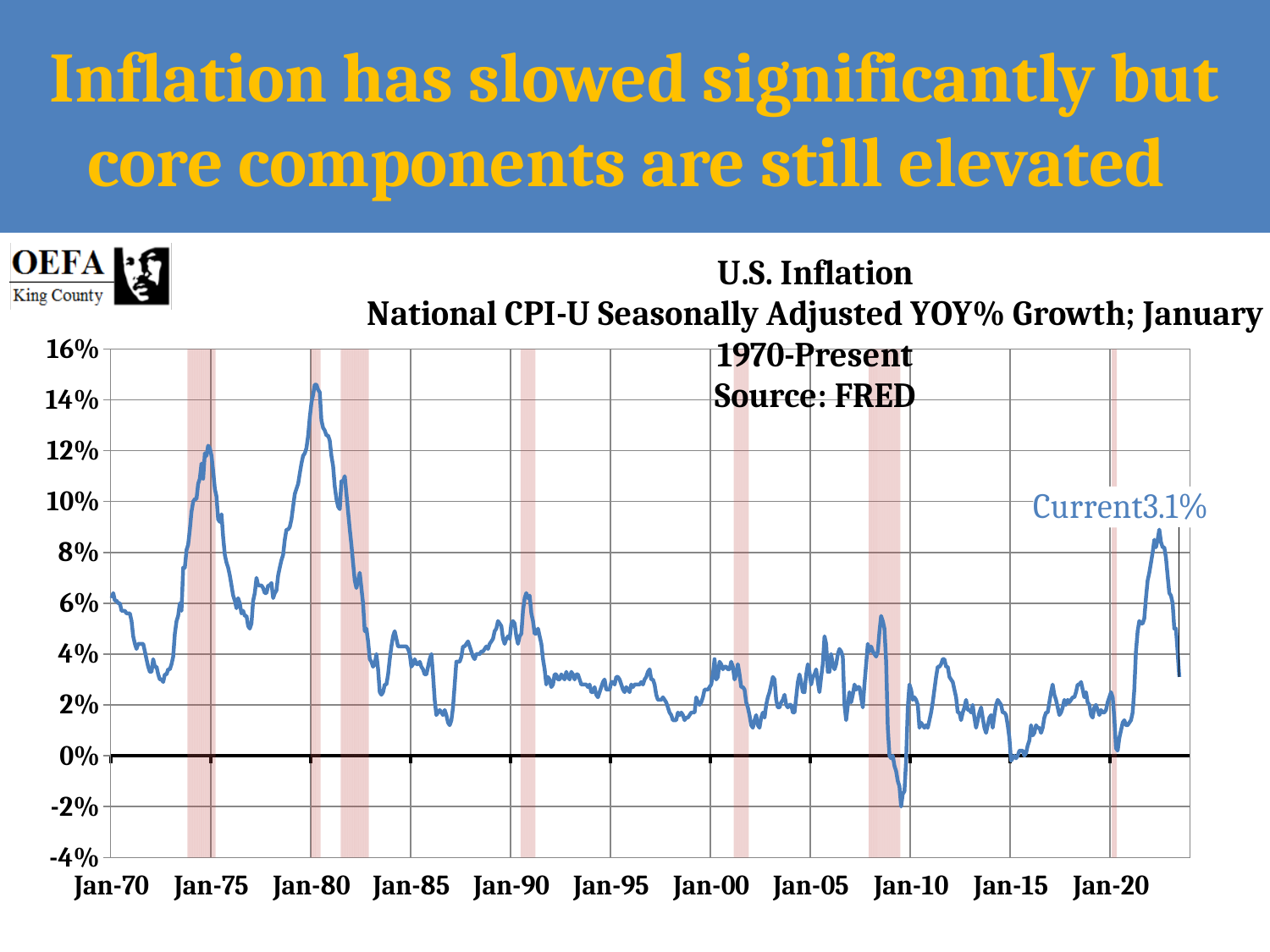
What kind of chart is shown on the slide? line chart Is the lowest value of the line, reached shortly after Jan-05 and before Jan-10, greater or less than 0%? less Which is higher: the peak after Jan-20 or the peak near Jan-90? the peak after Jan-20 Is the peak value of the line near Jan-80 greater or less than 14%? greater How many labels are shown on the x axis? 11 Which is higher: the peak near Jan-80 or the peak near Jan-75? the peak near Jan-80 From its peak after Jan-20 to the current value, does the line rise or fall? fall What is the current value of U.S. inflation labelled on the chart? 3.1% Is the peak value of the line after Jan-20 greater or less than 8%? greater Near which x-axis label does the line reach its highest value? Jan-80